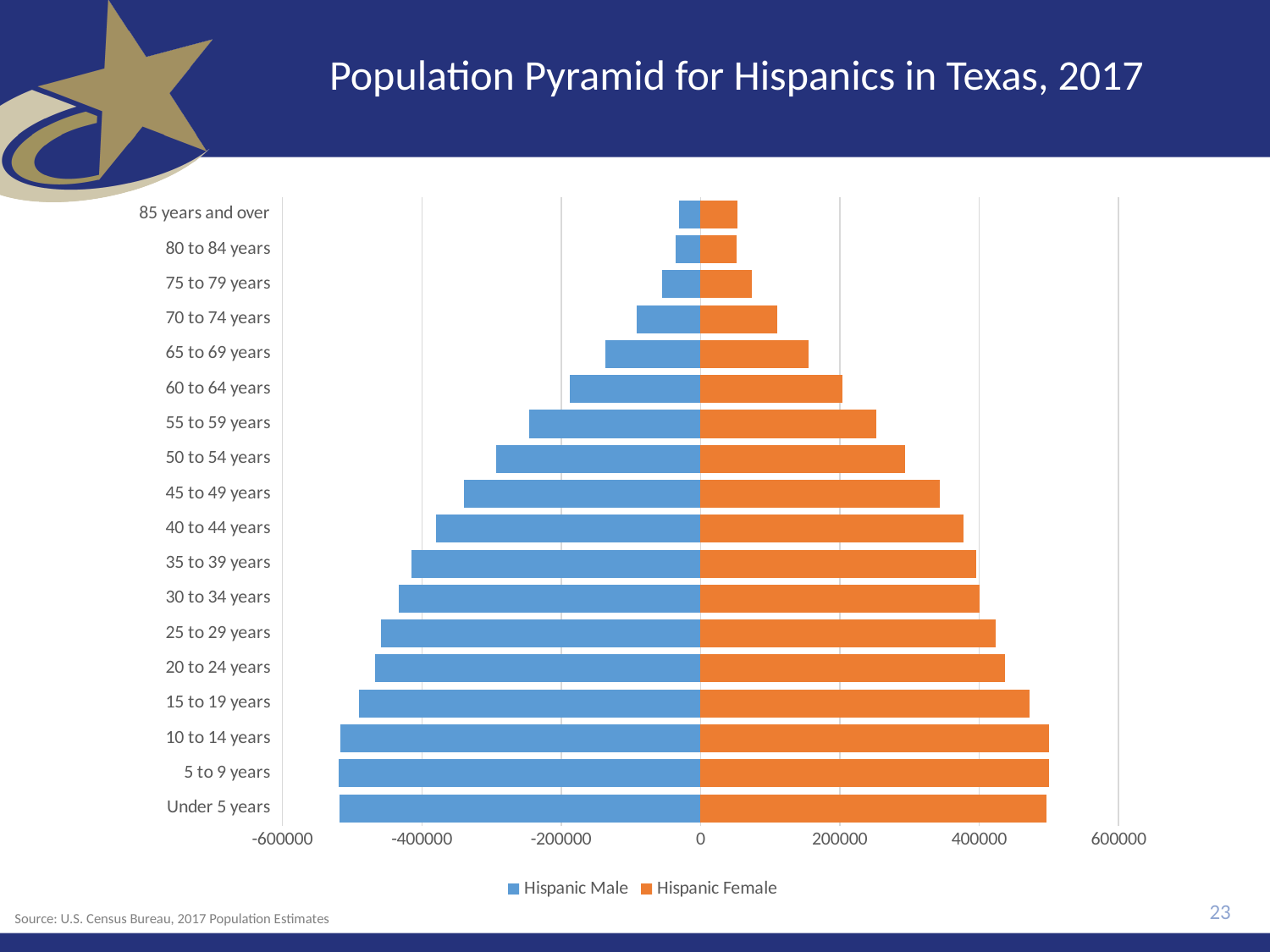
What is the title of the chart? Population Pyramid for Hispanics in Texas, 2017 Is the Hispanic Female value for 20 to 24 years greater or less than 400000? greater Do the Hispanic Female bars generally get longer or shorter as the age groups get older? shorter How many series does the legend list? 2 How many age groups are shown on the chart? 18 Which is larger for Hispanic Female: 15 to 19 years or 65 to 69 years? 15 to 19 years Is the Hispanic Female value for 85 years and over greater or less than 200000? less Is the Hispanic Female value for 10 to 14 years greater or less than 400000? greater Which series is shown in blue? Hispanic Male Which is larger for Hispanic Female: 70 to 74 years or 50 to 54 years? 50 to 54 years What kind of chart is shown on the slide? Bar chart